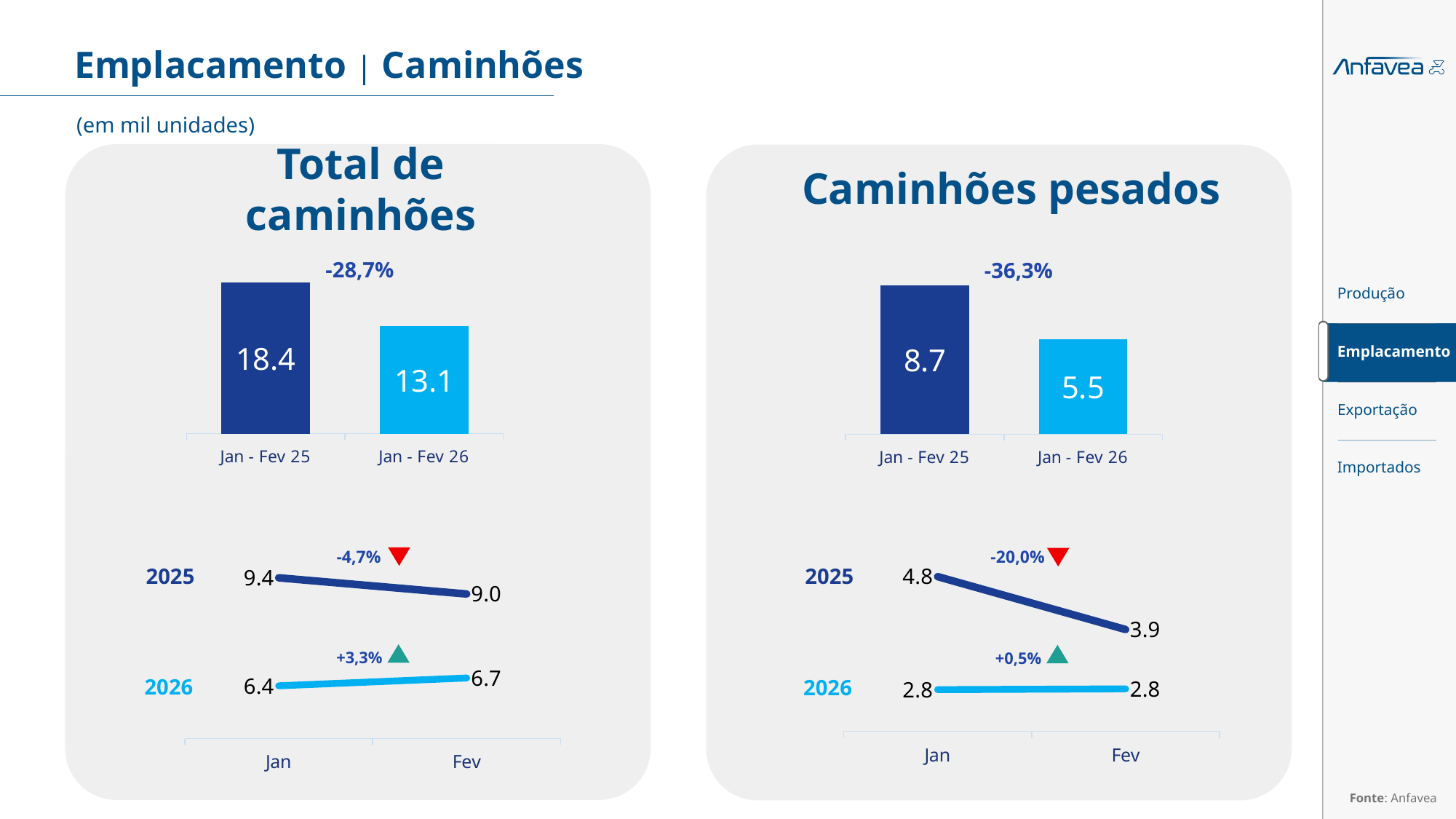
In the 'Caminhões pesados' bar chart, what is the value for Jan - Fev 26? 5.5 In the 'Caminhões pesados' line chart, what is the value for Jan in the 2025 series? 4.8 What kind of chart is the upper chart in the 'Total de caminhões' panel? bar chart In the 'Caminhões pesados' bar chart, which period has the higher value, Jan - Fev 25 or Jan - Fev 26? Jan - Fev 25 In the 'Total de caminhões' line chart, does the 2026 series rise or fall from Jan to Fev? rise In the 'Total de caminhões' line chart, what is the value for Fev in the 2025 series? 9.0 In the 'Total de caminhões' bar chart, what is the difference between Jan - Fev 25 and Jan - Fev 26? 5.3 In the 'Total de caminhões' bar chart, what is the value for Jan - Fev 25? 18.4 In the 'Caminhões pesados' line chart, what percentage change is shown for the 2025 series from Jan to Fev? -20,0% In the 'Total de caminhões' bar chart, what is the value for Jan - Fev 26? 13.1 What percentage change is shown above the bars in the 'Caminhões pesados' bar chart? -36,3% In the 'Caminhões pesados' bar chart, what is the difference between Jan - Fev 25 and Jan - Fev 26? 3.2